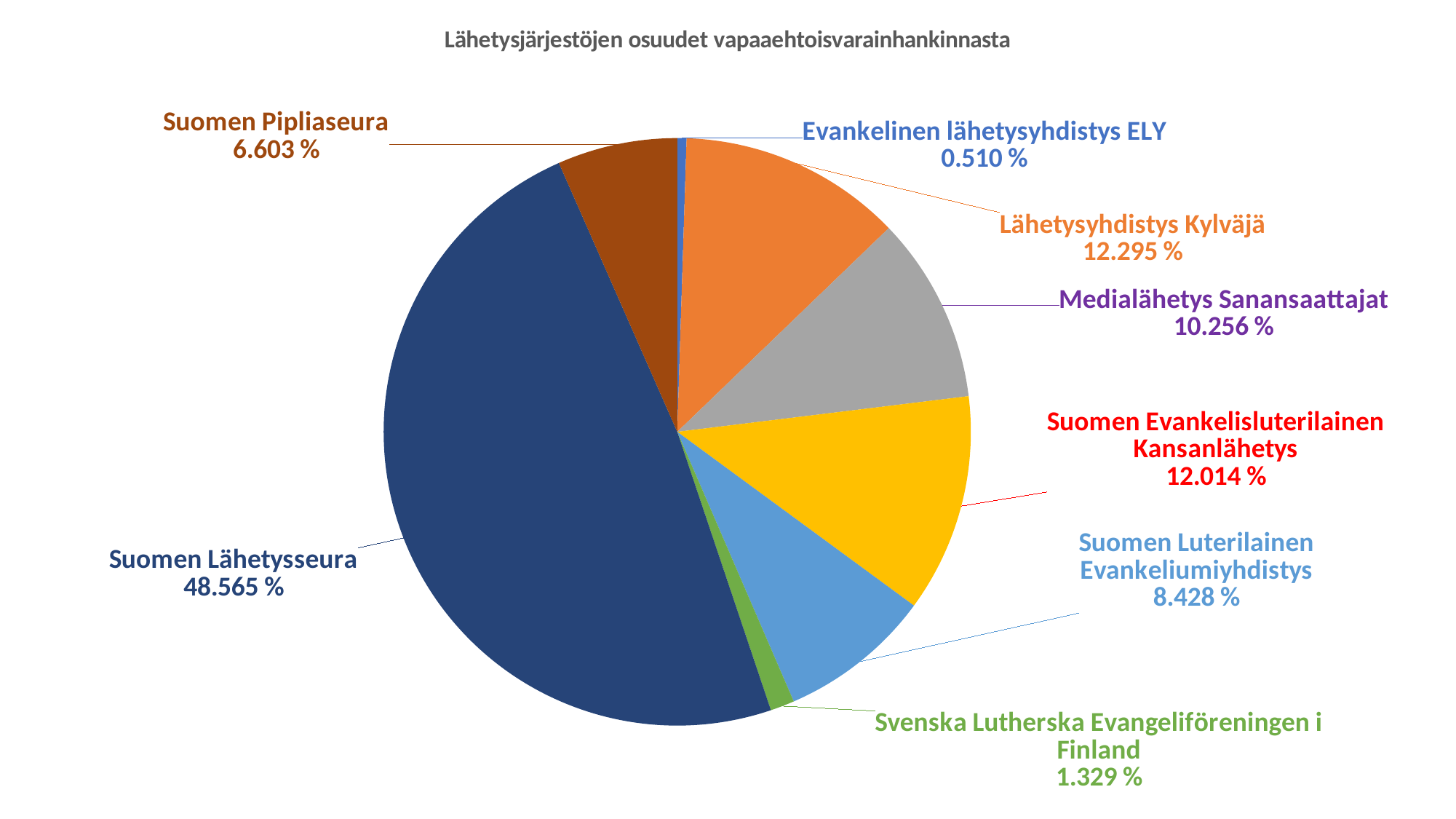
Which organisation has the smallest share of the pie? Evankelinen lähetysyhdistys ELY Which organisation has the largest share of the pie? Suomen Lähetysseura What kind of chart is shown on the slide? pie chart What is the title of the chart? Lähetysjärjestöjen osuudet vapaaehtoisvarainhankinnasta What share does Lähetysyhdistys Kylväjä have? 12.295 % What share does Svenska Lutherska Evangeliföreningen i Finland have? 1.329 % How many slices does the pie chart have? 8 What colour is the slice for Suomen Evankelisluterilainen Kansanlähetys? yellow What share does Medialähetys Sanansaattajat have? 10.256 % Which has the larger share, Suomen Pipliaseura or Suomen Luterilainen Evankeliumiyhdistys? Suomen Luterilainen Evankeliumiyhdistys What share does Suomen Lähetysseura have? 48.565 % What is the difference between the shares of Suomen Lähetysseura and Lähetysyhdistys Kylväjä? 36.270 %